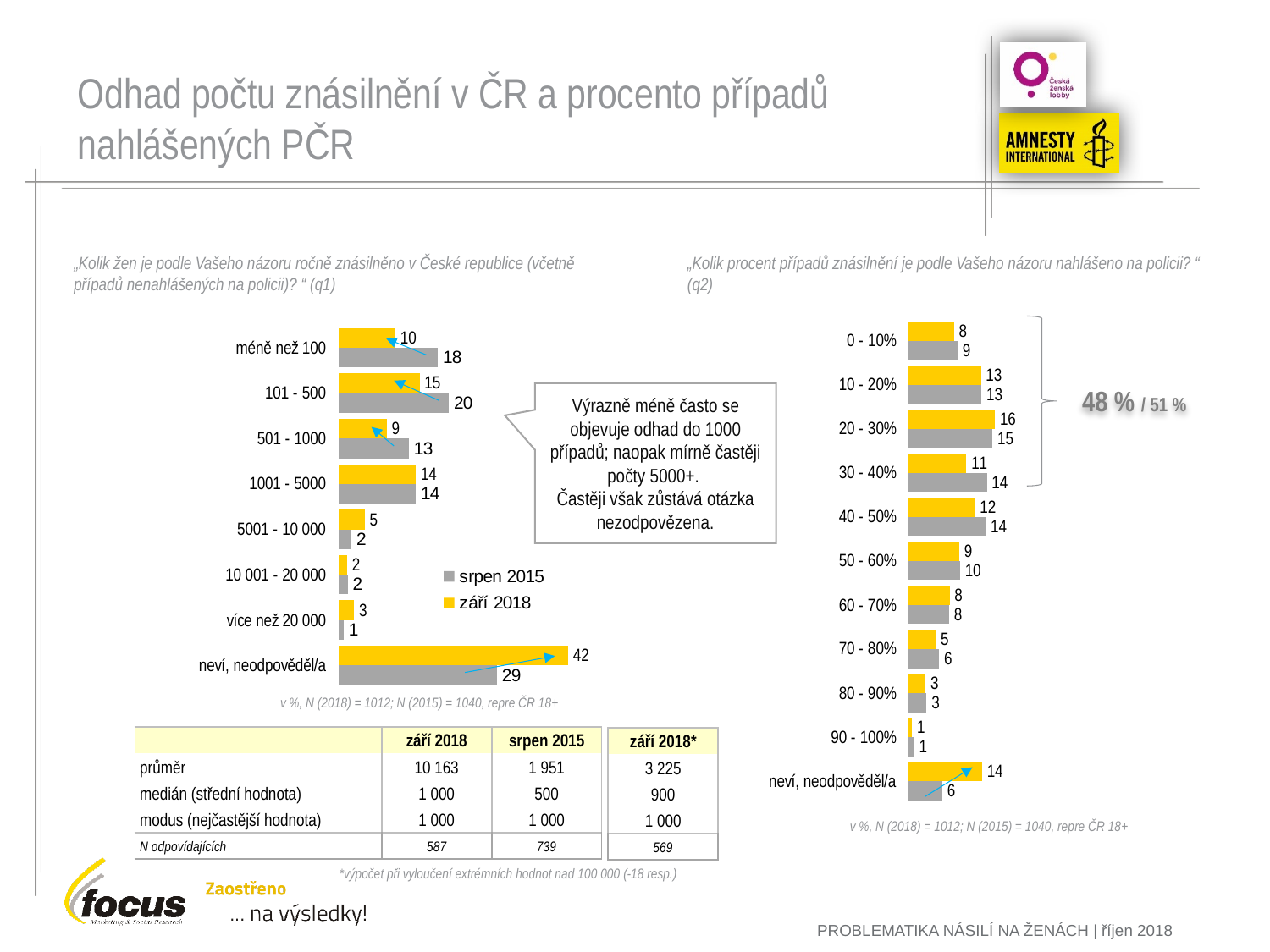
In the left chart (q1), which category has the highest value in the září 2018 series? neví, neodpověděl/a In the right chart (q2), what is the value of the yellow (září 2018) bar for '20 - 30%'? 16 In the right chart (q2), what is the difference between the yellow (září 2018) and grey (srpen 2015) values for 'neví, neodpověděl/a'? 8 In the right chart (q2), what is the value of the grey (srpen 2015) bar for 'neví, neodpověděl/a'? 6 In the left chart (q1), which category has the lowest value in the srpen 2015 series? více než 20 000 In the left chart (q1), what is the difference between the srpen 2015 and září 2018 values for 'méně než 100'? 8 In the right chart (q2), which is larger for '30 - 40%': the yellow (září 2018) bar or the grey (srpen 2015) bar? srpen 2015 In the left chart (q1), what is the value for 'neví, neodpověděl/a' in the září 2018 series? 42 In the left chart (q1), how many series does the legend list? 2 In the left chart (q1), how many categories are shown? 8 In the left chart (q1), what is the value for '101 - 500' in the srpen 2015 series? 20 What type of chart is the right chart (q2)? bar chart